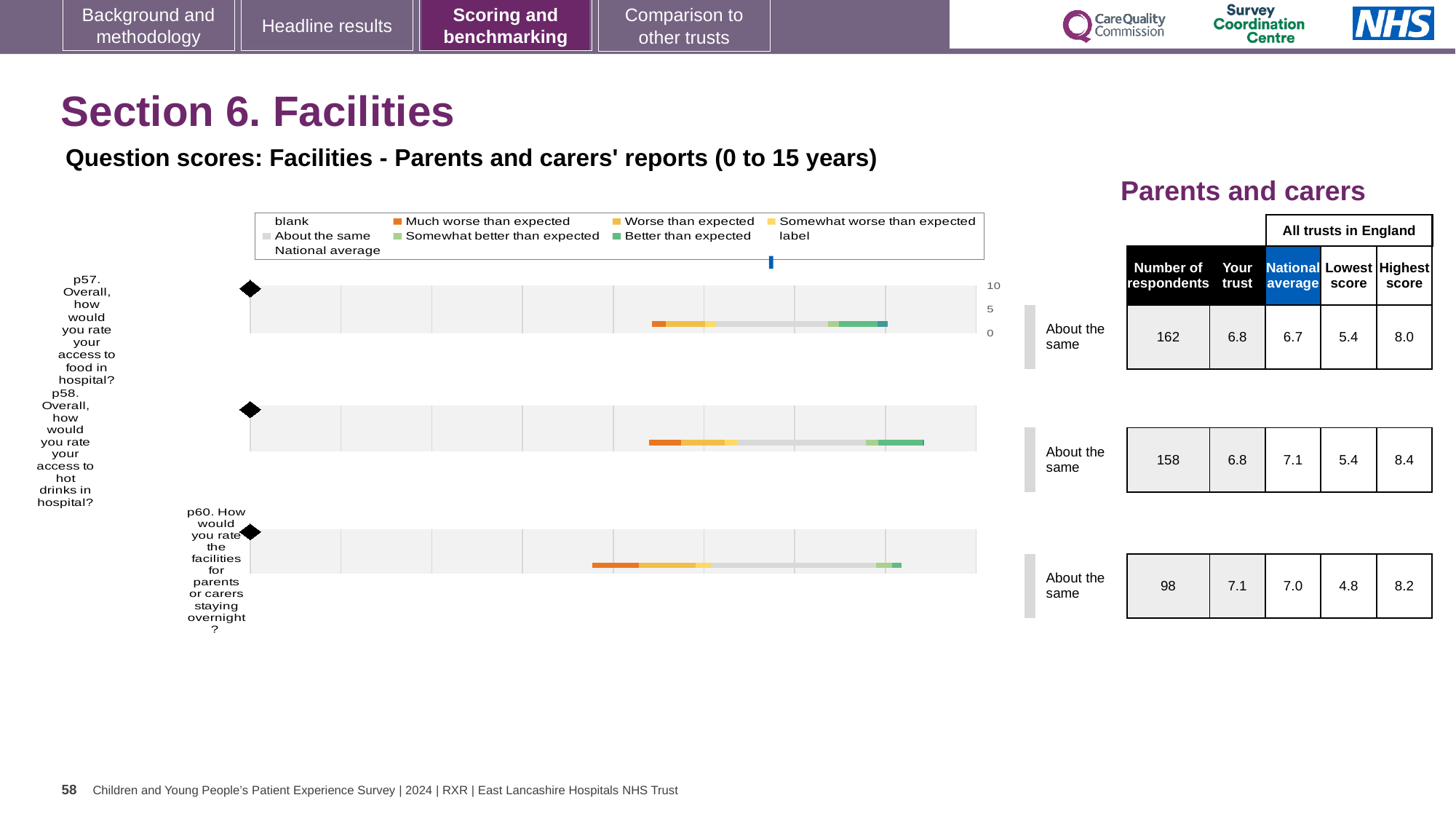
What benchmark category is shown next to the chart for p60 (facilities for parents or carers staying overnight)? About the same How many survey questions (rows) are plotted in the chart? 3 What benchmark category is shown next to the chart for p57 (access to food in hospital)? About the same What is the highest value shown on the chart's numeric axis? 10 In the table beside the chart, is the 'Your trust' score for p57 larger or smaller than the national average for p57? larger In the table beside the chart, what is the 'Your trust' score for p57 (access to food in hospital)? 6.8 In the table beside the chart, what is the difference between the highest score and the lowest score for p58 (access to hot drinks in hospital)? 3.0 In the table beside the chart, what is the number of respondents for p60 (facilities for parents or carers staying overnight)? 98 Which legend entry is shown in dark orange? Much worse than expected In the table beside the chart, what is the national average for p58 (access to hot drinks in hospital)? 7.1 In the table beside the chart, which question has the highest 'Your trust' score? p60 (facilities for parents or carers staying overnight) What kind of chart is used to show the question scores for p57, p58 and p60? bar chart